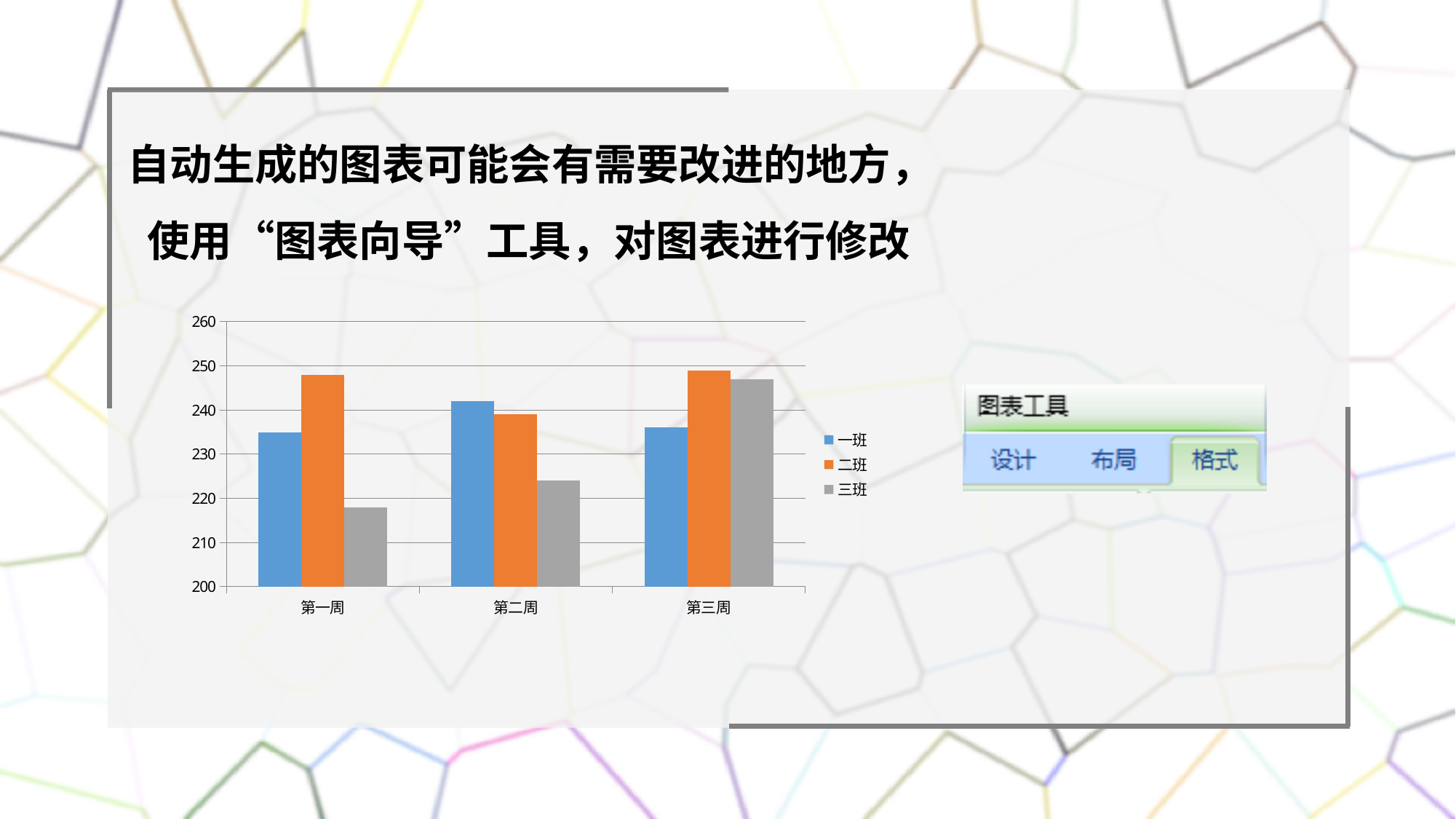
What kind of chart is shown on the slide? bar chart In which week is the value for 三班 the lowest? 第一周 Is the value for 三班 in 第一周 greater or less than 230? less Is the value for 三班 in 第三周 greater or less than 240? greater Is the value for 三班 in 第二周 greater or less than 230? less Which series is shown in orange in the chart? 二班 How many series does the chart's legend list? 3 In 第一周, which is larger: the value for 一班 or the value for 三班? 一班 How many categories (weeks) are shown on the x axis of the chart? 3 In 第三周, which is larger: the value for 二班 or the value for 一班? 二班 Do the values for 三班 rise or fall from 第一周 to 第三周? rise